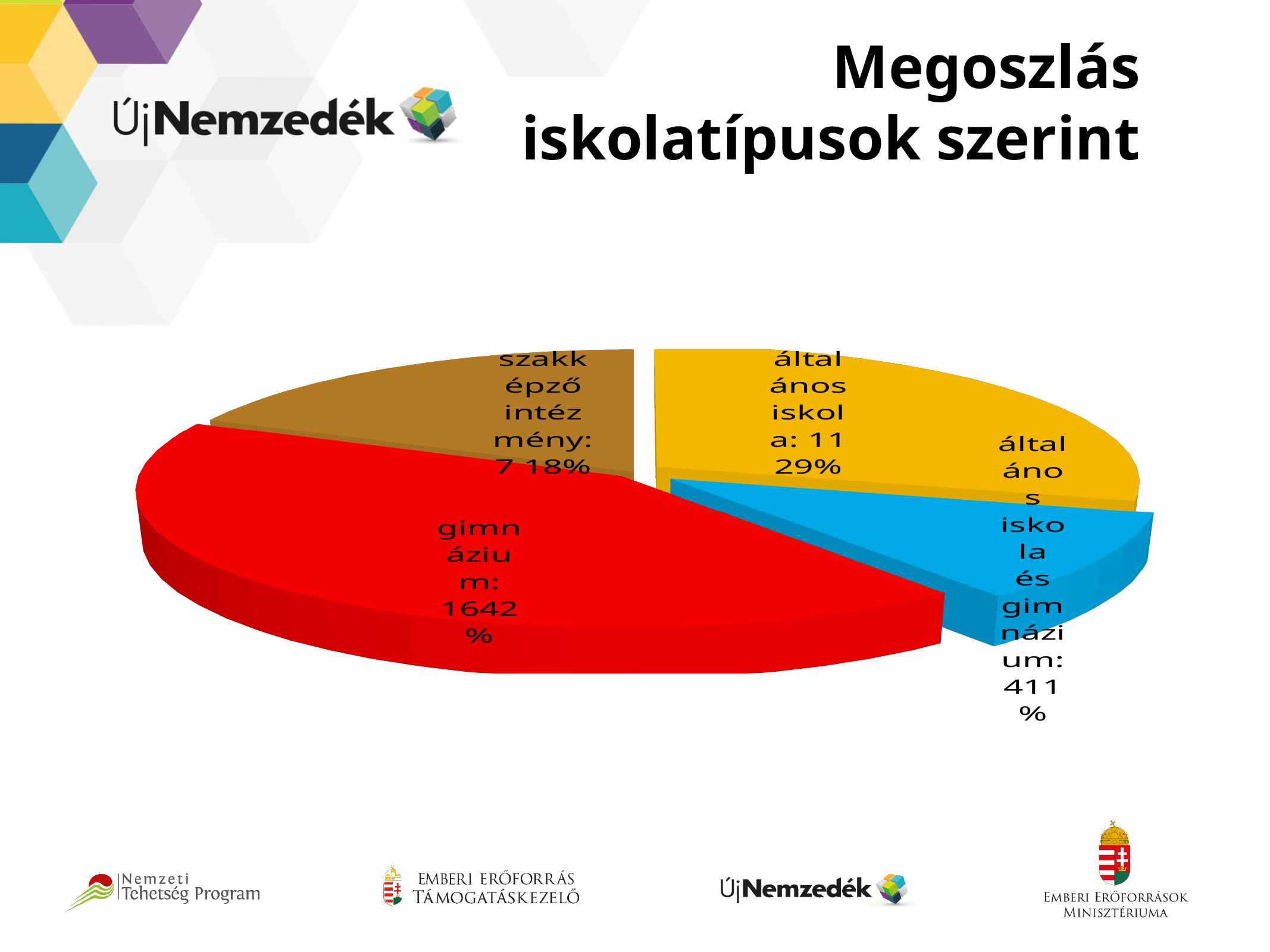
Which slice is larger: általános iskola or szakképző intézmény? általános iskola What is the title of the slide containing the pie chart? Megoszlás iskolatípusok szerint What is the difference in percentage share between the gimnázium slice and the általános iskola slice? 13 percentage points What share of the pie does the gimnázium slice represent? 42% What kind of chart is shown on the slide? pie chart Which school type has the largest slice of the pie? gimnázium What share of the pie does the általános iskola és gimnázium slice represent? 11% Which school type has the smallest slice of the pie? általános iskola és gimnázium What share of the pie does the szakképző intézmény slice represent? 18% How many slices does the pie chart have? 4 What colour is the gimnázium slice of the pie chart? red